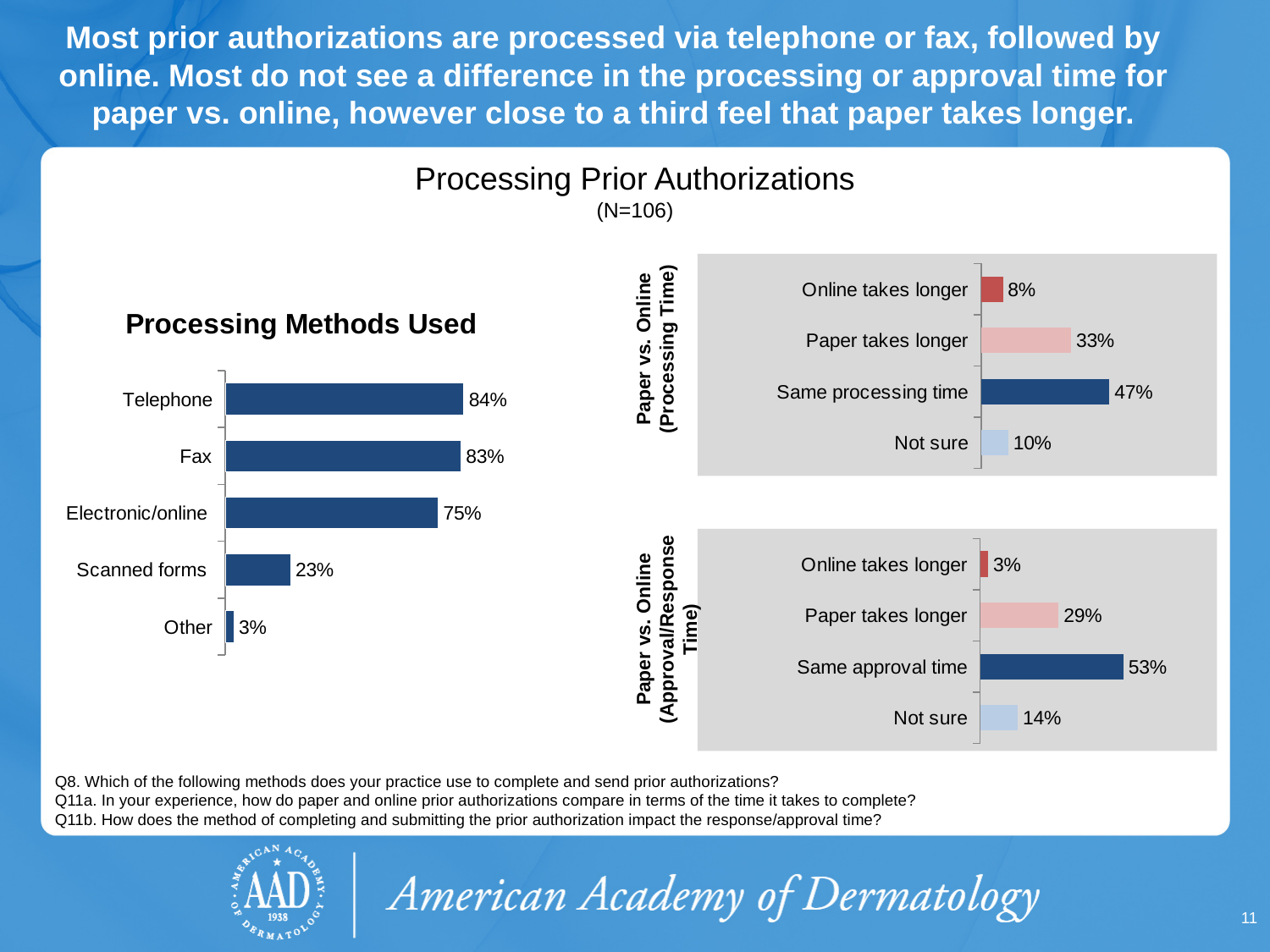
In the Paper vs. Online (Approval/Response Time) chart, what percentage said Same approval time? 53% In the Paper vs. Online (Approval/Response Time) chart, what is the difference between Paper takes longer and Online takes longer? 26% What type of chart is the Processing Methods Used chart? Bar chart In the Processing Methods Used chart, how many methods are listed? 5 In the Processing Methods Used chart, what is the difference between the Fax and Scanned forms values? 60% In the Paper vs. Online (Processing Time) chart, which is larger: Online takes longer or Not sure? Not sure In the Processing Methods Used chart, what percentage of respondents use Telephone? 84% In the Paper vs. Online (Approval/Response Time) chart, which response has the lowest value? Online takes longer In the Processing Methods Used chart, which method has the lowest value? Other What sample size (N) is shown under the Processing Prior Authorizations title? N=106 In the Paper vs. Online (Processing Time) chart, what percentage said Paper takes longer? 33% In the Paper vs. Online (Processing Time) chart, which response has the highest value? Same processing time